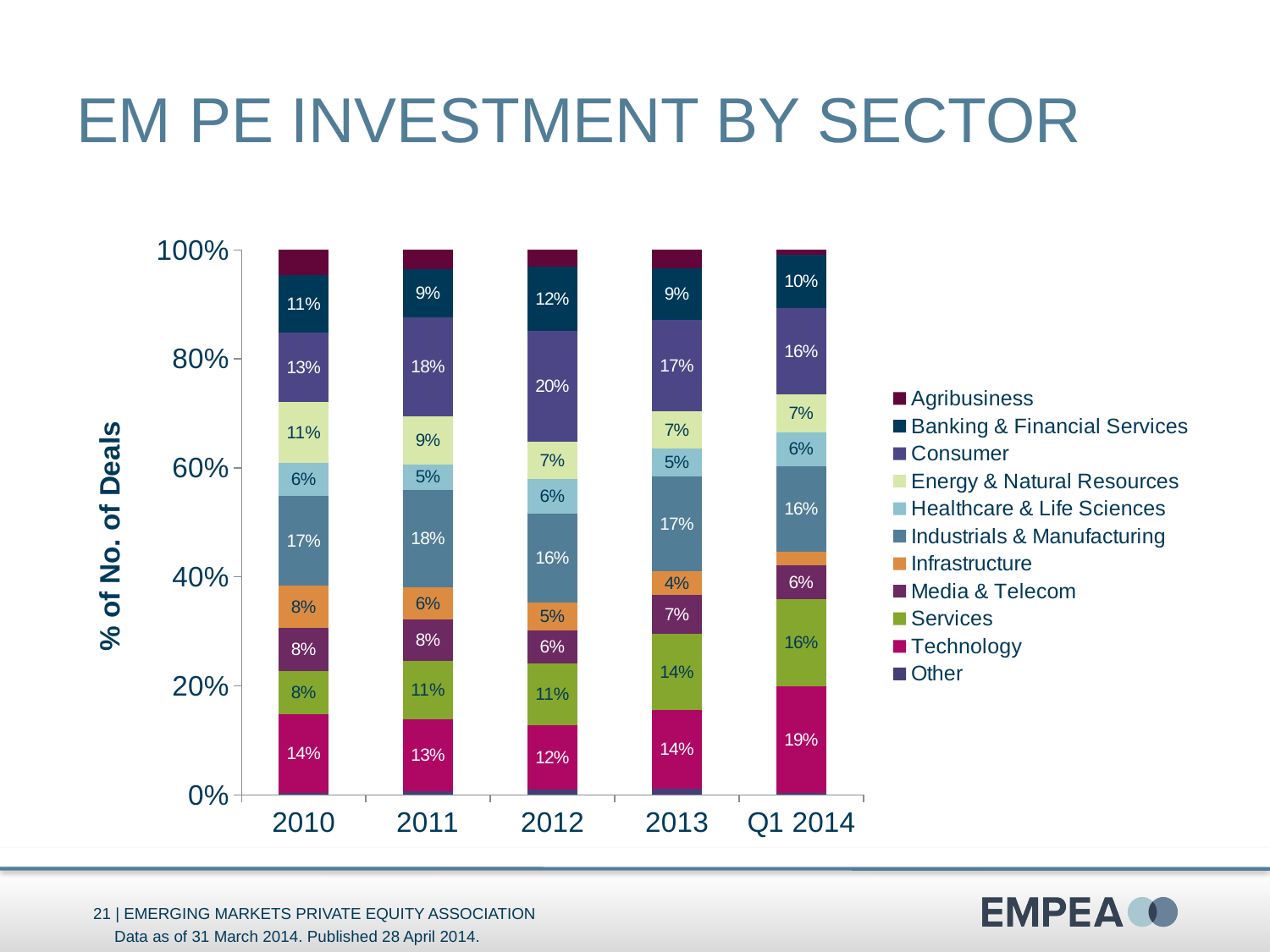
What is the y-axis label of the chart? % of No. of Deals What type of chart is shown on the slide? Stacked bar chart What share of deals did Technology account for in Q1 2014? 19% What share of deals did Industrials & Manufacturing have in 2011? 18% In which year did the Consumer sector have its highest share of deals? 2012 What is the difference between the Services share in Q1 2014 and in 2010? 8 percentage points In which period did Technology have its highest share of deals? Q1 2014 How many sectors does the legend list? 11 How many time periods are shown on the x axis? 5 What was the Consumer sector's share of deals in 2012? 20% Did the Infrastructure share of deals rise or fall from 2010 to 2013? Fall Which was larger in 2013, the Technology share or the Media & Telecom share? Technology